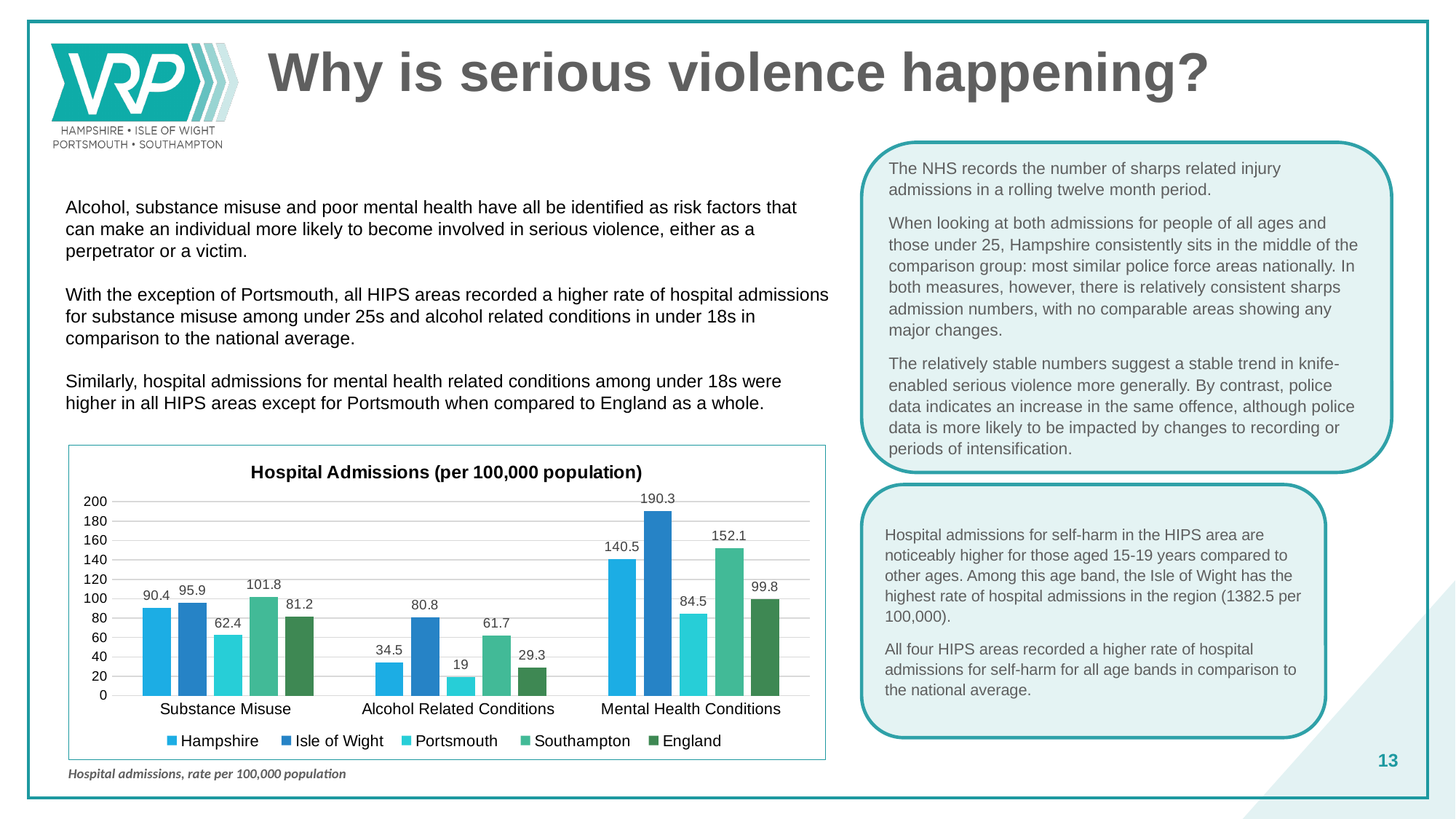
Which area has the highest rate for Mental Health Conditions? Isle of Wight Which is larger for Alcohol Related Conditions: the Isle of Wight rate or the Southampton rate? Isle of Wight What kind of chart is shown on the slide? Bar chart What is the hospital admissions rate for Portsmouth for Alcohol Related Conditions? 19 What is the difference between the Isle of Wight and Hampshire rates for Mental Health Conditions? 49.8 How many series does the chart legend list? 5 What is the hospital admissions rate for England for Mental Health Conditions? 99.8 Which area has the lowest rate for Substance Misuse? Portsmouth What is the hospital admissions rate for Southampton for Substance Misuse? 101.8 What is the title of the chart? Hospital Admissions (per 100,000 population) Is the Hampshire value for Mental Health Conditions greater or less than 120? greater How many categories are shown on the x axis of the chart? 3